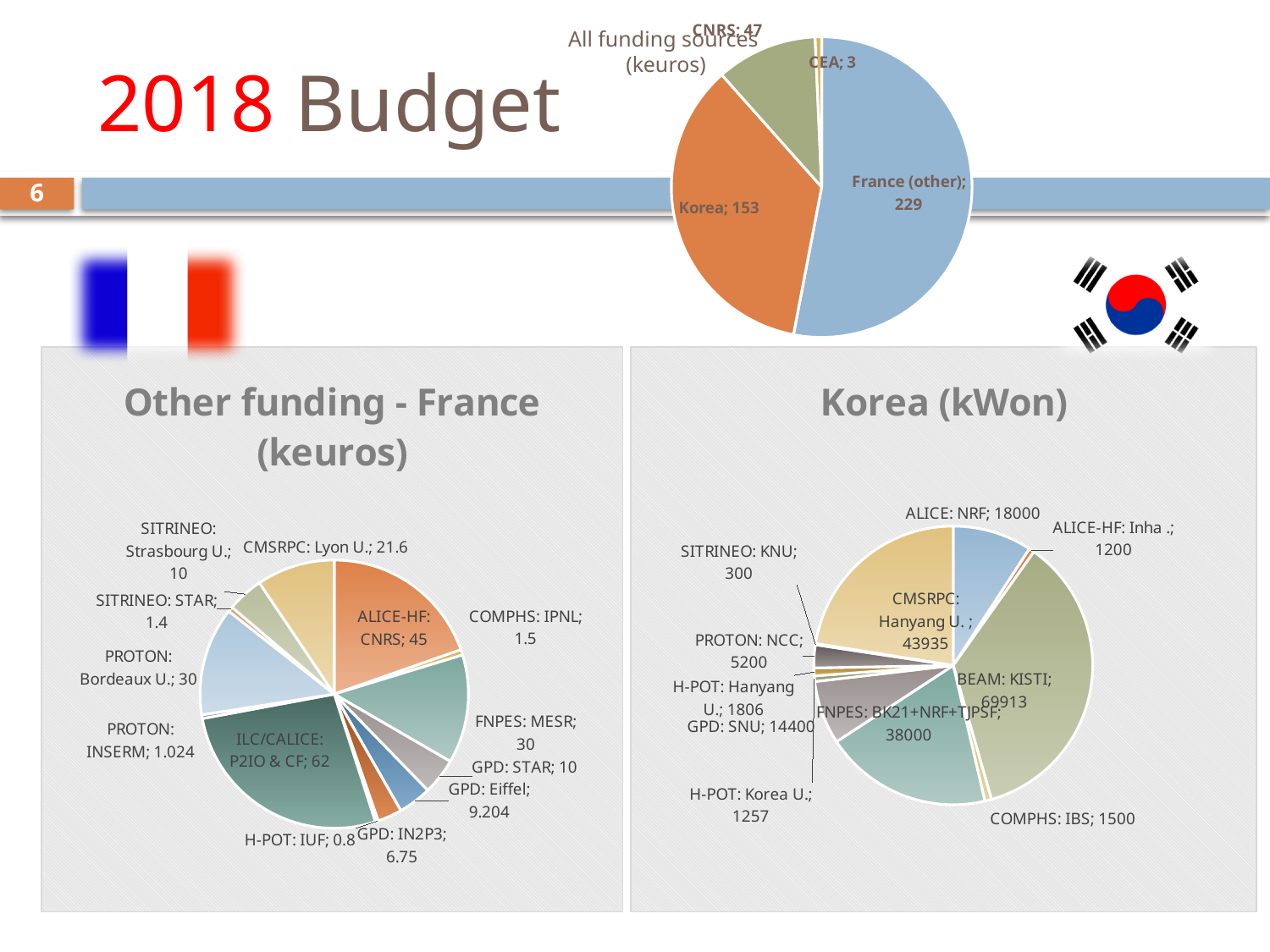
In the 'Other funding - France (keuros)' pie chart, what is the value for ILC/CALICE: P2IO & CF? 62 How many slices does the 'Other funding - France (keuros)' pie chart have? 13 In the 'Korea (kWon)' pie chart, what is the value for CMSRPC: Hanyang U.? 43935 In the 'Other funding - France (keuros)' pie chart, which category has the smallest value? H-POT: IUF In the 'Korea (kWon)' pie chart, which is larger: FNPES: BK21+NRF+TJPSF or CMSRPC: Hanyang U.? CMSRPC: Hanyang U. In the 'All funding sources (keuros)' pie chart, what is the value for Korea? 153 In the 'Korea (kWon)' pie chart, which category has the largest value? BEAM: KISTI In the 'All funding sources (keuros)' pie chart, which funding source has the smallest slice? CEA How many slices does the 'Korea (kWon)' pie chart have? 11 What kind of chart is 'Other funding - France (keuros)'? Pie chart In the 'All funding sources (keuros)' pie chart, what is the difference between France (other) and Korea? 76 In the 'All funding sources (keuros)' pie chart, which funding source has the largest slice? France (other)